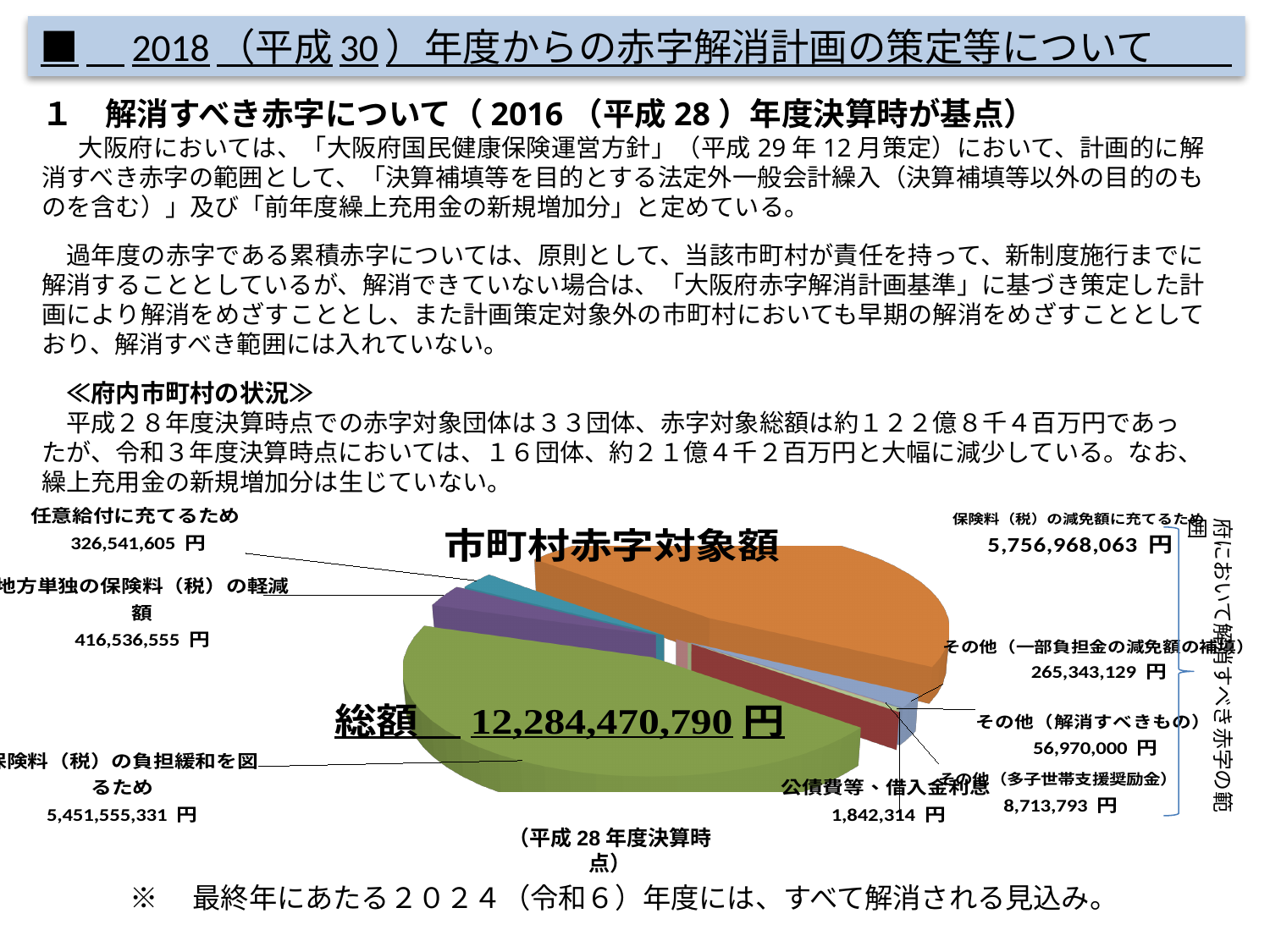
Which is larger: 地方単独の保険料（税）の軽減額 or 任意給付に充てるため? 地方単独の保険料（税）の軽減額 What is the value for 任意給付に充てるため in the pie chart? 326,541,605 円 What is the total amount (総額) shown for the pie chart? 12,284,470,790 円 What kind of chart is shown on the slide? pie chart What is the value for その他（多子世帯支援奨励金） in the pie chart? 8,713,793 円 Which category has the smallest value in the pie chart? 公債費等、借入金利息 What is the value for 公債費等、借入金利息 in the pie chart? 1,842,314 円 How many categories are shown in the pie chart? 8 What is the title of the pie chart? 市町村赤字対象額 What is the difference between 保険料（税）の減免額に充てるため and 保険料（税）の負担緩和を図るため? 305,412,732 円 What is the value for 保険料（税）の減免額に充てるため in the pie chart? 5,756,968,063 円 Which category has the largest value in the pie chart? 保険料（税）の減免額に充てるため